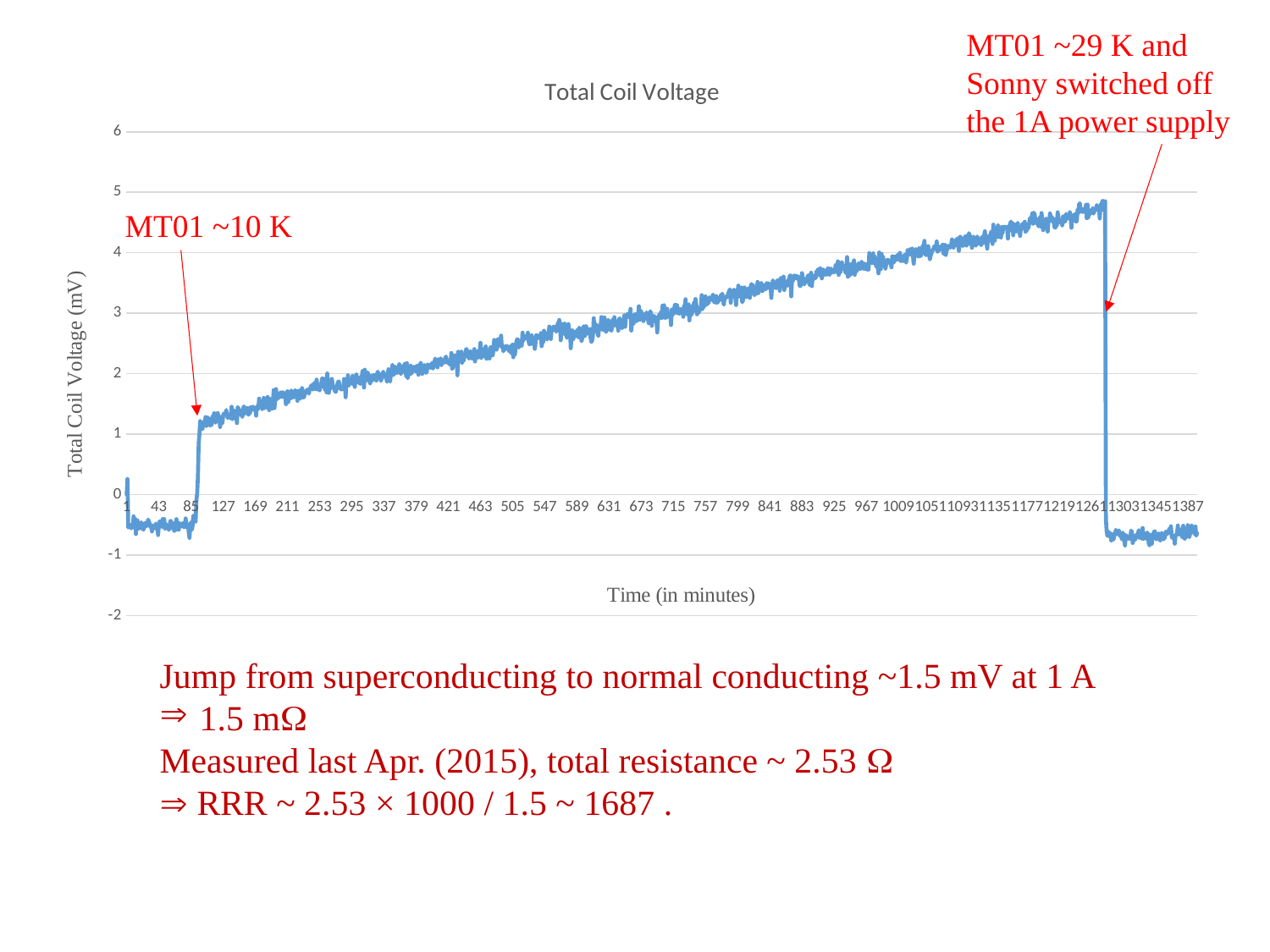
What kind of chart is shown on the slide? line chart What is the highest tick value shown on the vertical axis? 6 Is the value for time 1387 greater or less than 0? less Is the value for time 715 greater or less than 2? greater What is the title of the chart? Total Coil Voltage Is the value for time 1261 greater or less than 4? greater Between time 127 and time 1261, does the total coil voltage rise or fall along the x axis? rise What is the label of the vertical axis of the chart? Total Coil Voltage (mV) Which is larger, the value at time 1009 or the value at time 253? time 1009